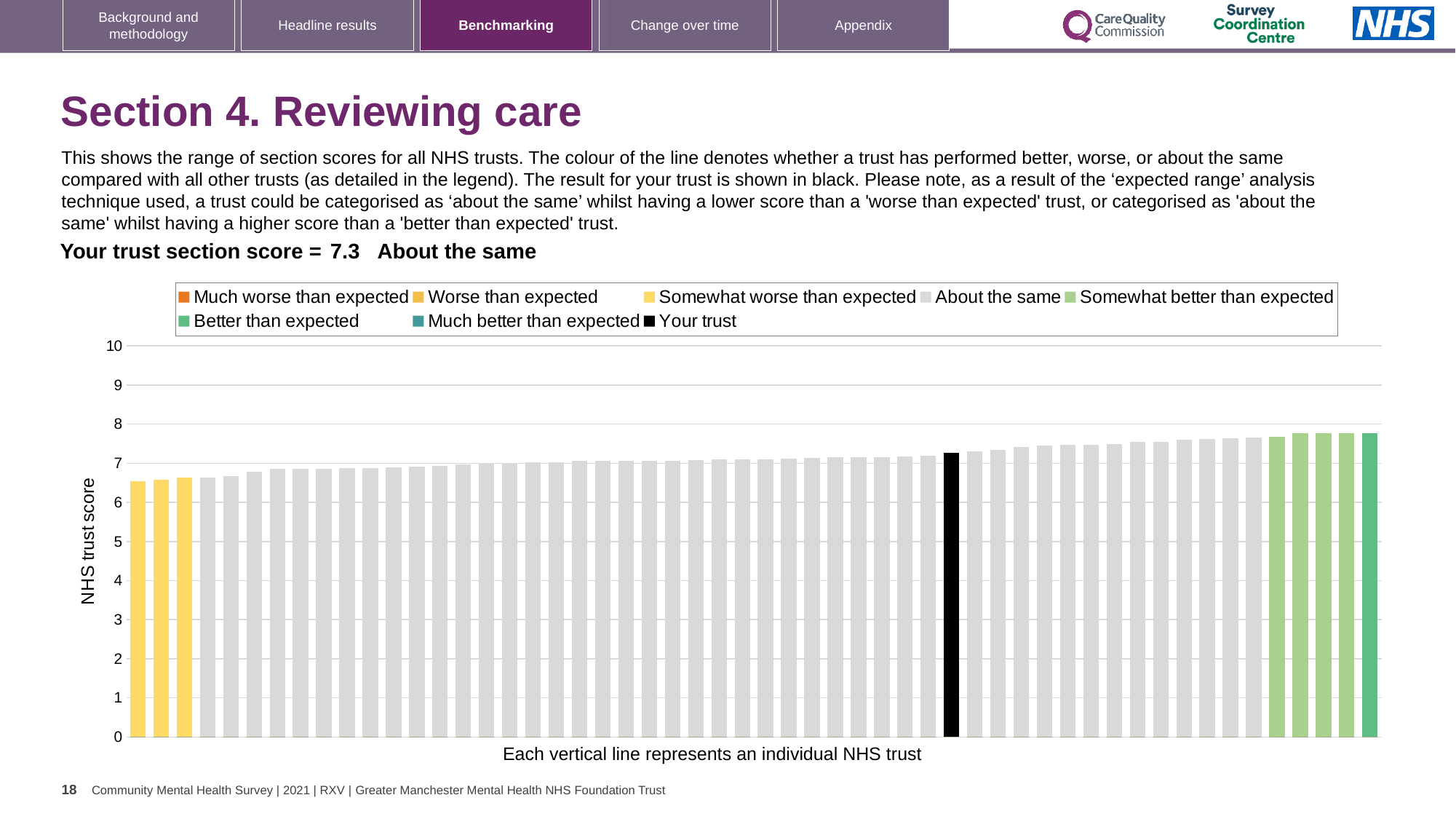
What is the section score for your trust? 7.3 Is the value for your trust's bar greater or less than 7? greater How many entries does the chart legend list? 8 What is the label on the vertical axis of the chart? NHS trust score Is your trust's bar higher or lower than the rightmost bar on the chart? lower Which legend category does the highest bar on the chart belong to? Better than expected Which legend category do the lowest bars on the chart belong to? Somewhat worse than expected Do the bar values rise or fall from left to right along the x axis? rise What kind of chart is shown on the slide? bar chart Is the value of the highest bar on the chart greater or less than 8? less Which category is your trust placed in for this section? About the same Is the value of the lowest bar on the chart greater or less than 7? less